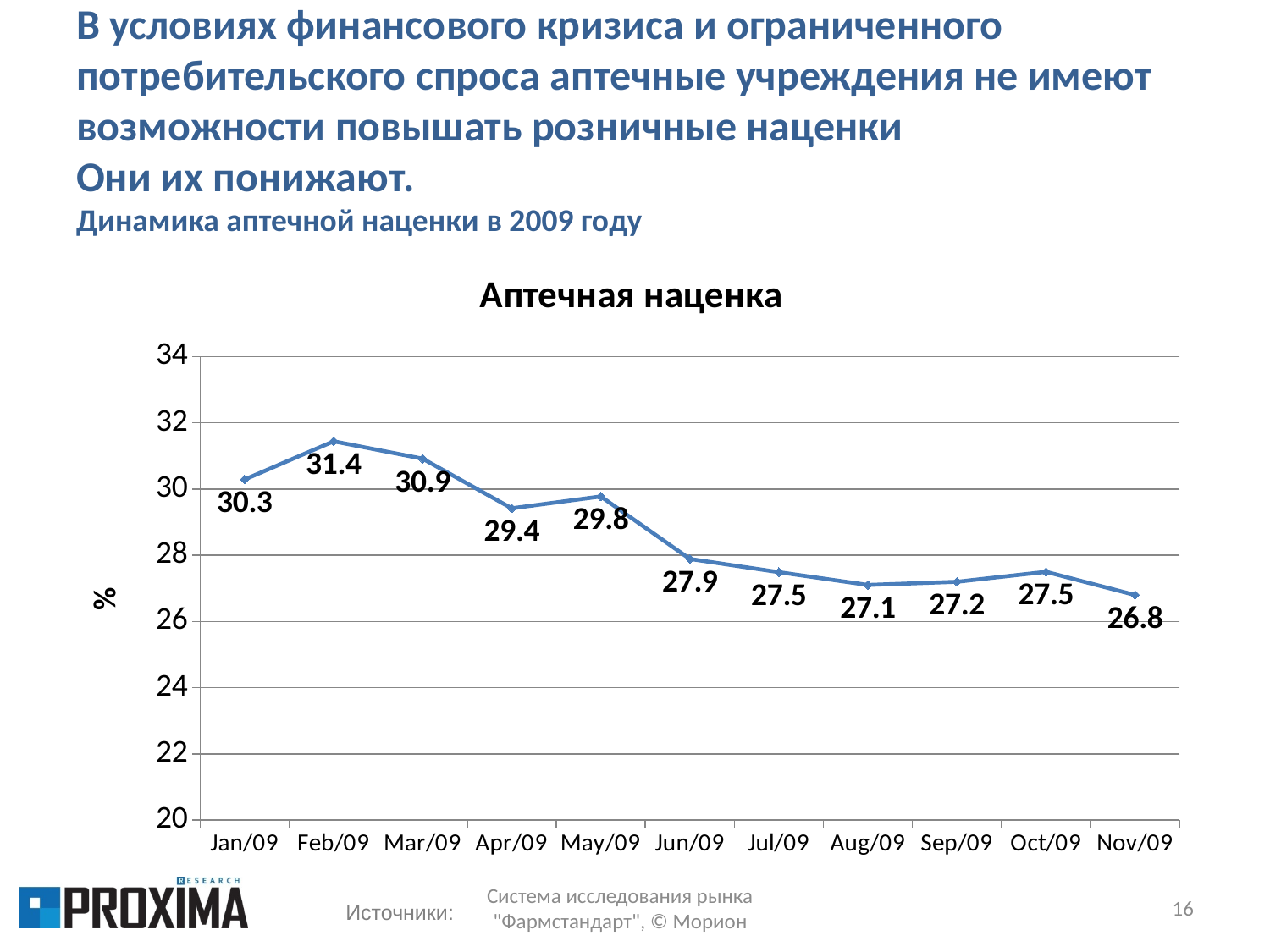
Which is larger, the value for Mar/09 or the value for May/09? Mar/09 What kind of chart is shown? line chart What is the title of the chart? Аптечная наценка Which month has the highest value? Feb/09 What is the difference between the values for Feb/09 and Nov/09? 4.6 What is the value for Nov/09? 26.8 What is the value for Jun/09? 27.9 Which month has the lowest value? Nov/09 What is the value for Feb/09? 31.4 How many months are plotted on the chart? 11 Is the value for Aug/09 greater or less than 28? less Do the values generally rise or fall from Jan/09 to Nov/09? fall